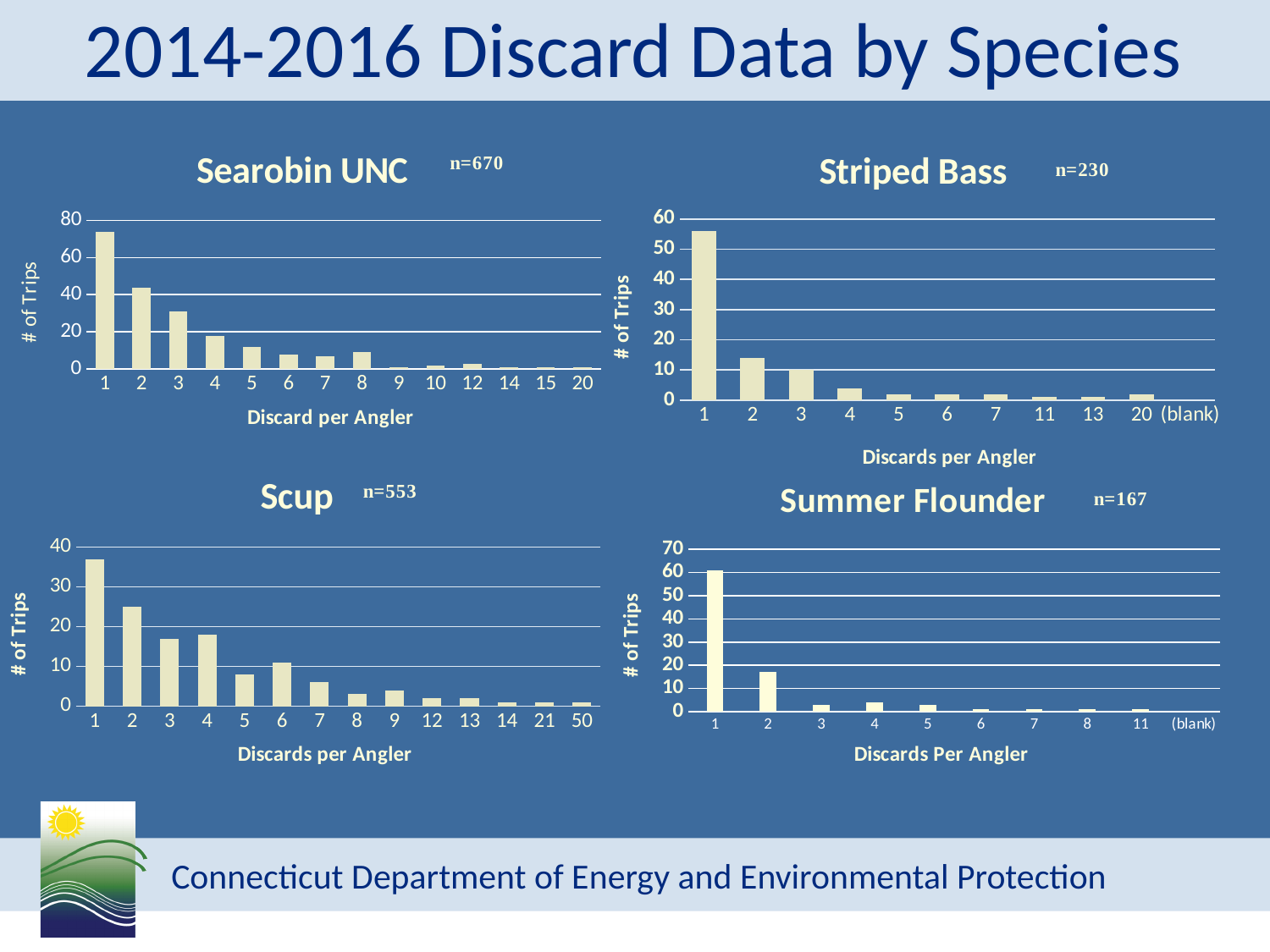
What kind of chart is the Searobin UNC chart? bar chart In the Summer Flounder chart, is the value for category 2 greater or less than 20? less In the Searobin UNC chart, is the value for category 4 greater or less than 20? less In the Searobin UNC chart, is the value for category 1 greater or less than 60? greater In the Scup chart, which is larger, the value for category 2 or the value for category 3? 2 In the Searobin UNC chart, which discard-per-angler category has the highest number of trips? 1 How many discard-per-angler categories are shown on the x axis of the Searobin UNC chart? 14 What sample size (n) is shown for the Summer Flounder chart? n=167 How many categories are shown on the x axis of the Striped Bass chart? 11